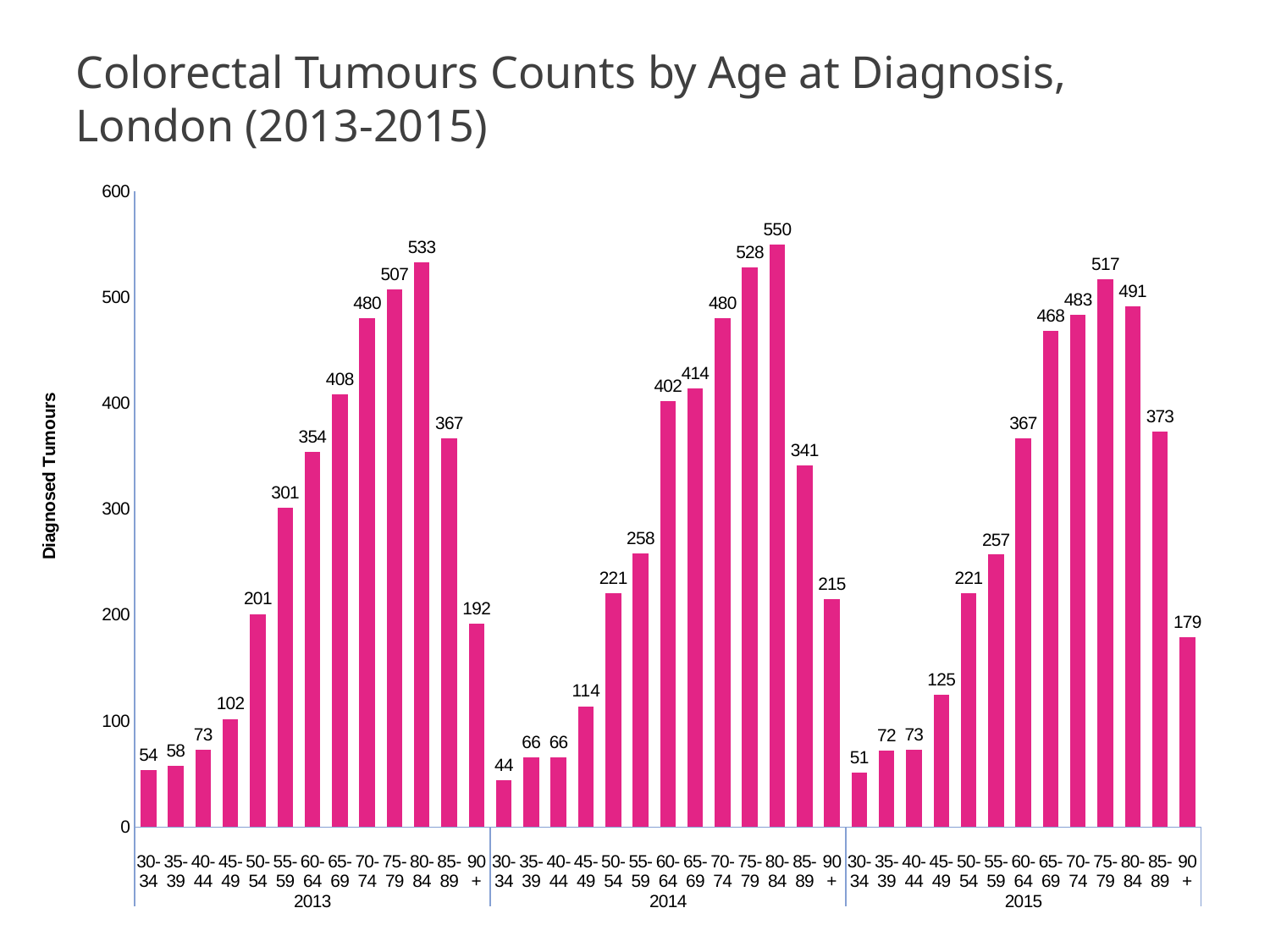
Which is larger: the 85-89 count in 2015 or the 85-89 count in 2014? 2015 How many bars are plotted in the chart in total? 39 How many age groups are shown for each year? 13 Is the value for the 65-69 age group in 2013 greater or less than 400? greater What is the label of the vertical axis? Diagnosed Tumours What type of chart is shown on the slide? Bar chart What is the count of diagnosed tumours for the 50-54 age group in 2013? 201 What is the count of diagnosed tumours for the 80-84 age group in 2014? 550 Which age group in 2015 has the highest count of diagnosed tumours? 75-79 What is the difference between the 80-84 counts in 2014 and 2013? 17 Which age group in 2014 has the lowest count of diagnosed tumours? 30-34 What is the count of diagnosed tumours for the 90+ age group in 2015? 179